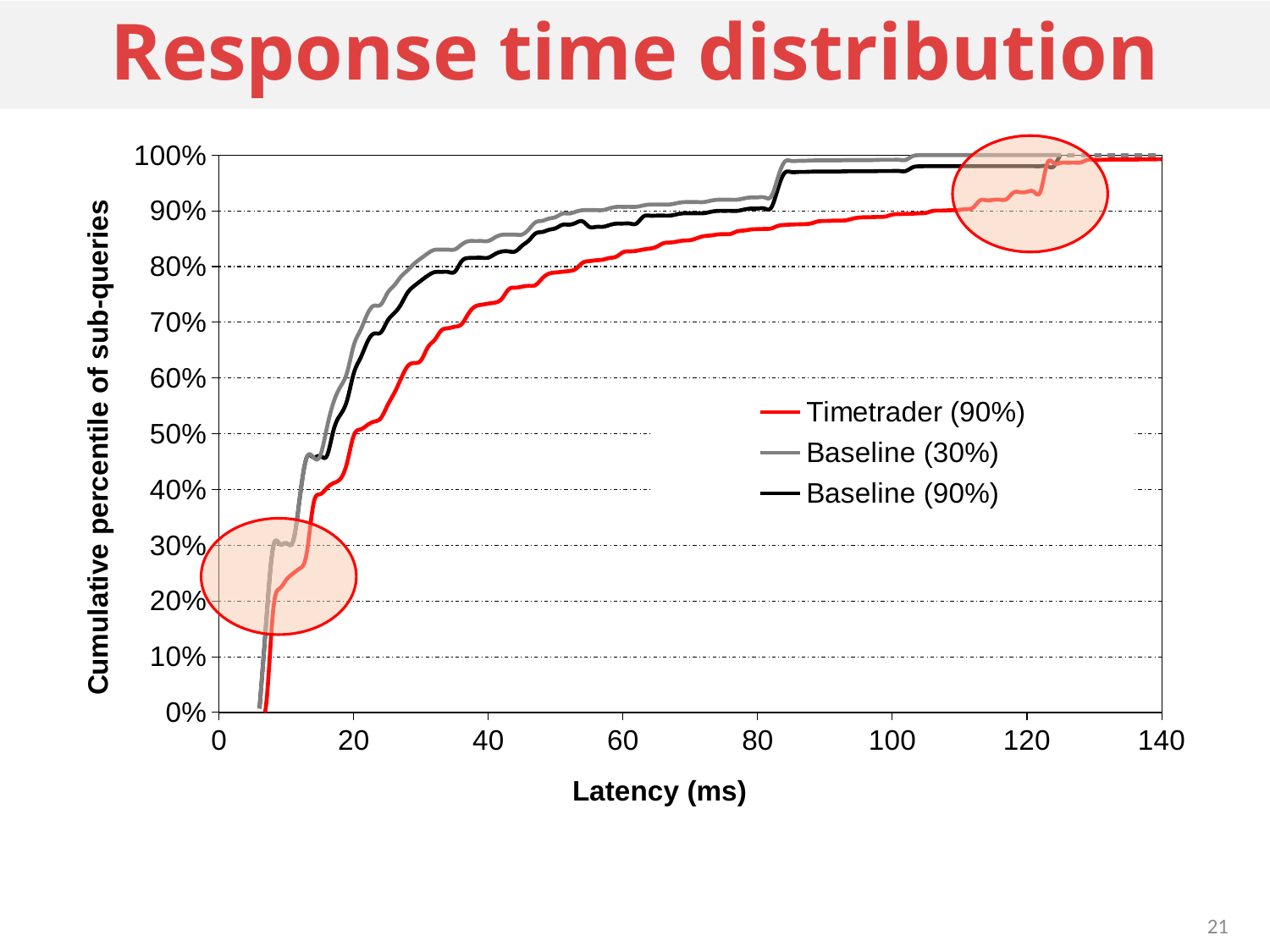
Is the value for Timetrader (90%) at a latency of 40 ms greater or less than 70%? greater What is the title of the chart? Response time distribution At a latency of 60 ms, which series has the lowest cumulative percentile? Timetrader (90%) Is the value for Baseline (90%) at a latency of 100 ms greater or less than 90%? greater What kind of chart is shown on the slide? Line chart How many series does the legend list? 3 Is the value for Baseline (30%) at a latency of 40 ms greater or less than 80%? greater At a latency of 40 ms, which series has the higher cumulative percentile, Baseline (30%) or Timetrader (90%)? Baseline (30%) At a latency of 20 ms, which series has the highest cumulative percentile? Baseline (30%) What is the label of the x axis? Latency (ms) Do the curves rise or fall as latency increases along the x axis? Rise